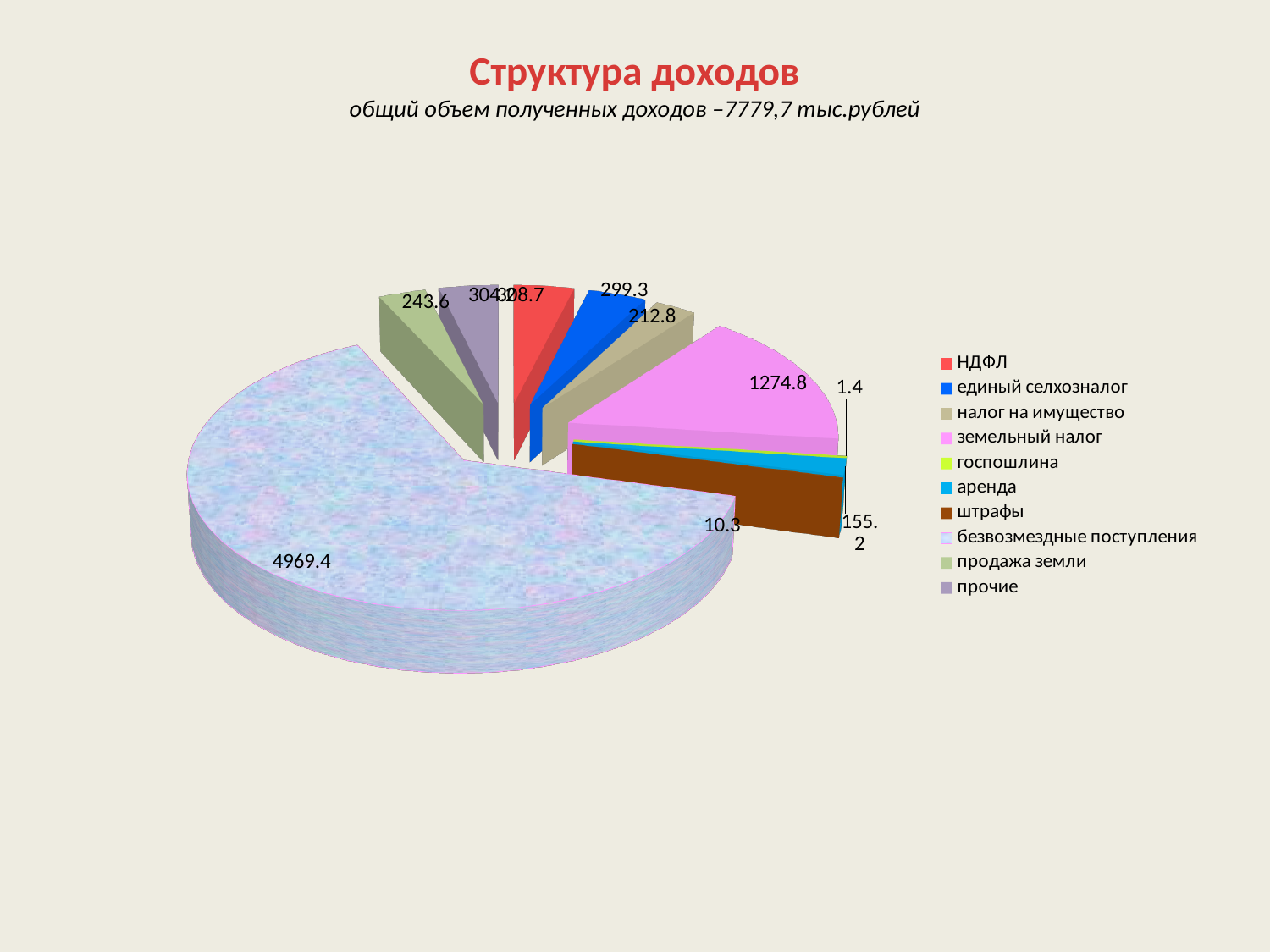
What is the value for безвозмездные поступления? 4969.4 What is the value for продажа земли? 243.6 What is the title of the chart on the slide? Структура доходов How many categories does the legend list? 10 What is the value for единый селхозналог? 299.3 Which category has the largest slice of the pie? безвозмездные поступления What is the value for земельный налог? 1274.8 What is the difference between the values for земельный налог and единый селхозналог? 975.5 What is the value for налог на имущество? 212.8 Which category has the smallest slice of the pie? госпошлина What kind of chart is shown on the slide? pie chart Which is larger, the value for земельный налог or the value for НДФЛ? земельный налог